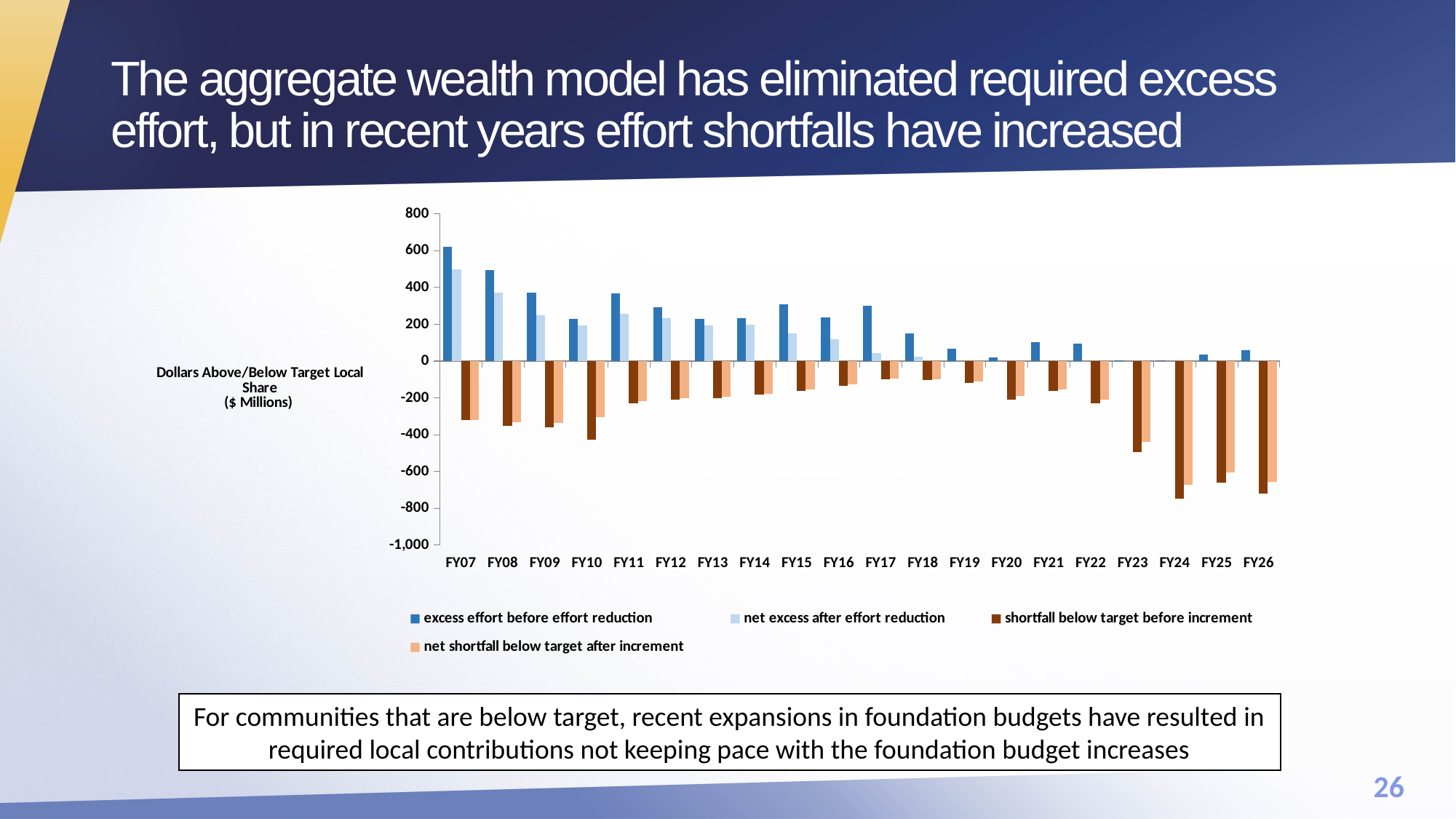
What kind of chart is shown on the slide? bar chart Is the value for 'excess effort before effort reduction' in FY19 greater or less than 200? less Which is larger, the 'excess effort before effort reduction' value for FY07 or for FY08? FY07 Which fiscal year has the larger (more negative) 'shortfall below target before increment', FY22 or FY23? FY23 What is the label on the chart's vertical axis? Dollars Above/Below Target Local Share ($ Millions) How many series does the chart's legend list? 4 Is the value for 'shortfall below target before increment' in FY10 greater or less than -200? less Is the value for 'shortfall below target before increment' in FY24 greater or less than -600? less How many fiscal years are shown along the x axis of the chart? 20 Does the 'excess effort before effort reduction' series generally rise or fall from FY07 to FY26? fall In which fiscal year is the value for 'excess effort before effort reduction' highest? FY07